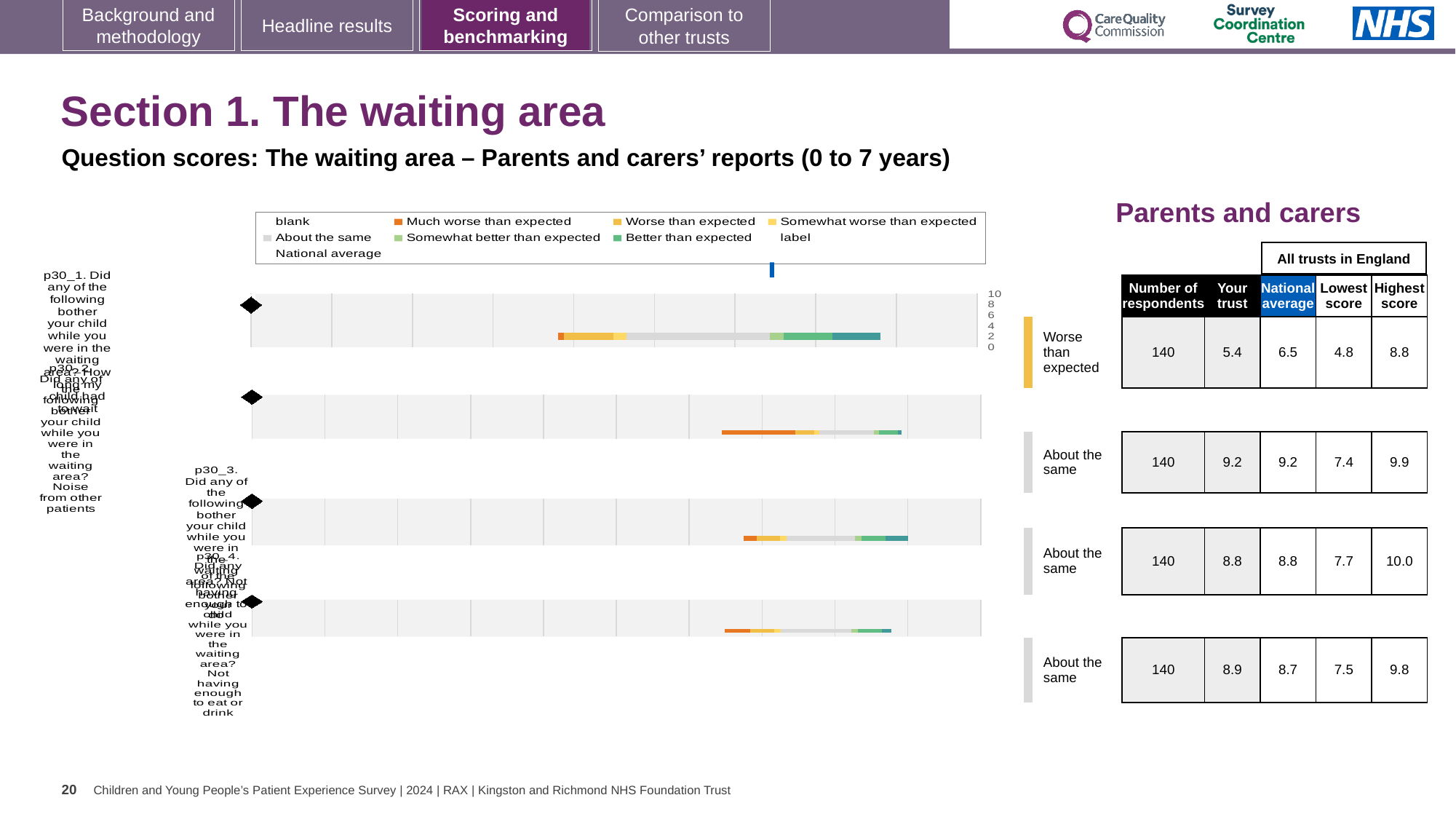
What is the 'Your trust' score for question p30_2 (noise from other patients)? 9.2 What kind of chart is shown on the slide? bar chart What is the difference between the national average and the 'Your trust' score for question p30_1? 1.1 What is the highest score across all trusts in England for question p30_3? 10.0 Which question is rated 'Worse than expected'? p30_1 What is the national average score for question p30_1? 6.5 What is the 'Your trust' score for question p30_1 (how long my child had to wait)? 5.4 For question p30_4, which is larger: the 'Your trust' score or the national average? Your trust Which question has the highest 'Your trust' score? p30_2 Which question has the lowest 'Your trust' score? p30_1 How many questions (bars) are plotted in the chart? 4 What is the lowest score across all trusts in England for question p30_4? 7.5